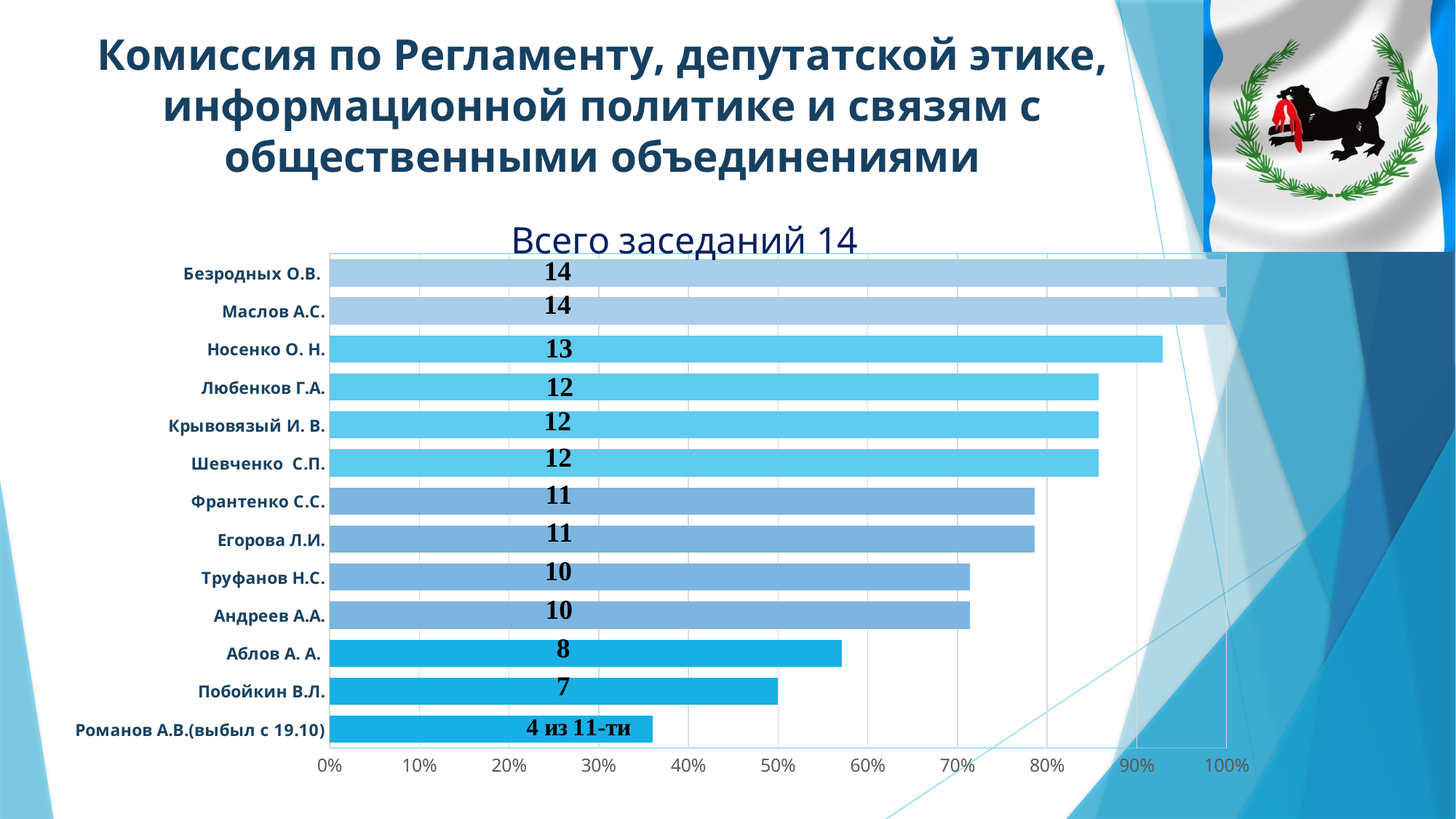
What is the difference between the data labels for Носенко О. Н. and Побойкин В.Л.? 6 Which category has the shortest bar? Романов А.В.(выбыл с 19.10) Is the bar for Аблов А. А. greater or less than 50%? greater What kind of chart is shown on the slide? bar chart What is the data label shown for Носенко О. Н.? 13 Which has a larger value, Аблов А. А. or Побойкин В.Л.? Аблов А. А. What is the data label shown for Аблов А. А.? 8 What is the data label shown for Романов А.В.(выбыл с 19.10)? 4 из 11-ти What is the data label shown for Труфанов Н.С.? 10 What is the title of the chart? Всего заседаний 14 How many categories (deputies) are shown in the chart? 13 What is the data label shown for Побойкин В.Л.? 7